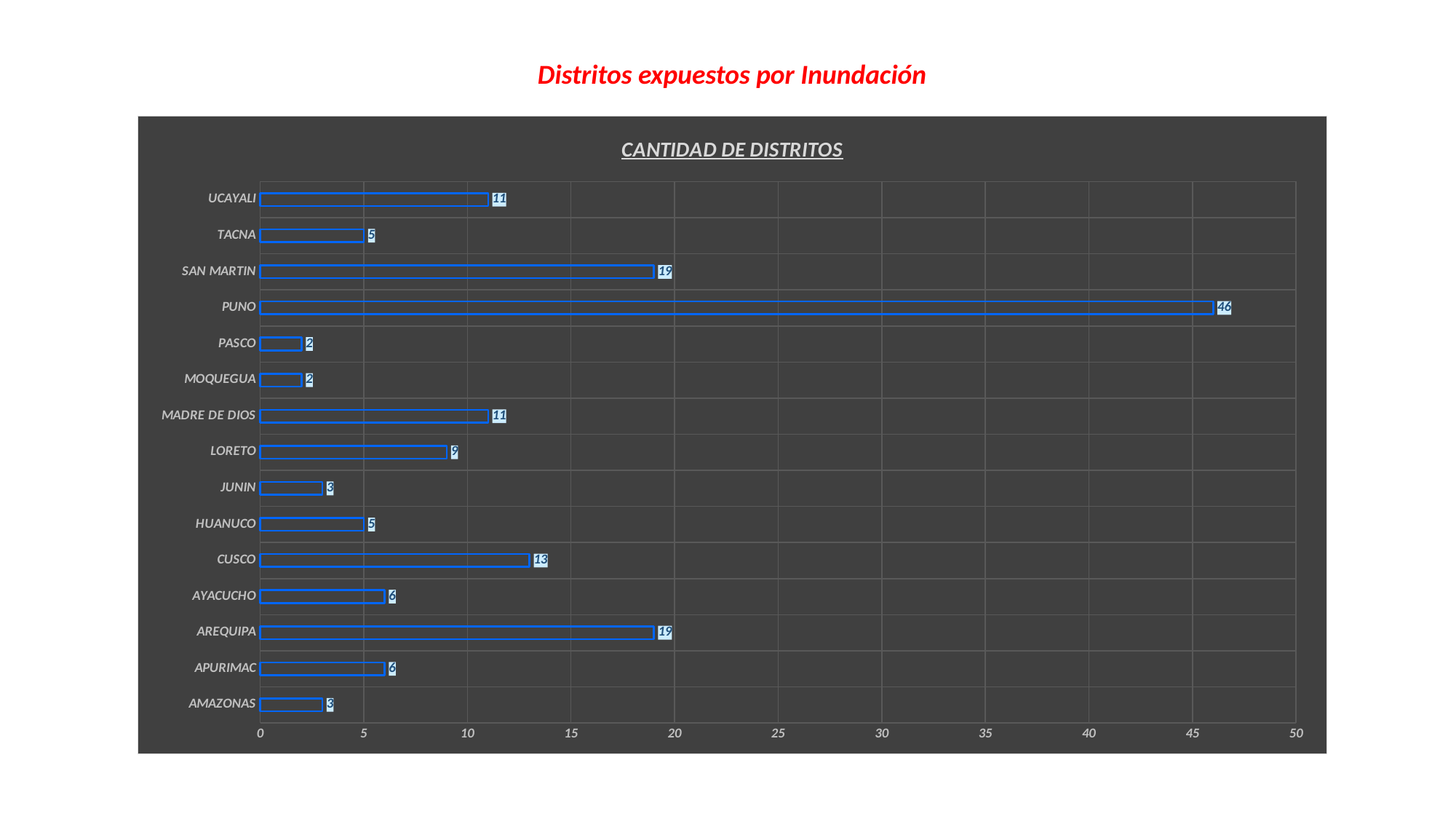
Which category has the highest value? PUNO What is the difference between the values for PUNO and SAN MARTIN? 27 What is the value for PUNO? 46 What is the value for CUSCO? 13 What kind of chart is shown? bar chart How many categories are shown on the chart? 15 Which is larger, the value for AREQUIPA or the value for MADRE DE DIOS? AREQUIPA What is the title of the chart? CANTIDAD DE DISTRITOS Which is larger, the value for HUANUCO or the value for AYACUCHO? AYACUCHO Is the value for SAN MARTIN greater or less than 20? less What is the difference between the values for CUSCO and UCAYALI? 2 What is the value for LORETO? 9